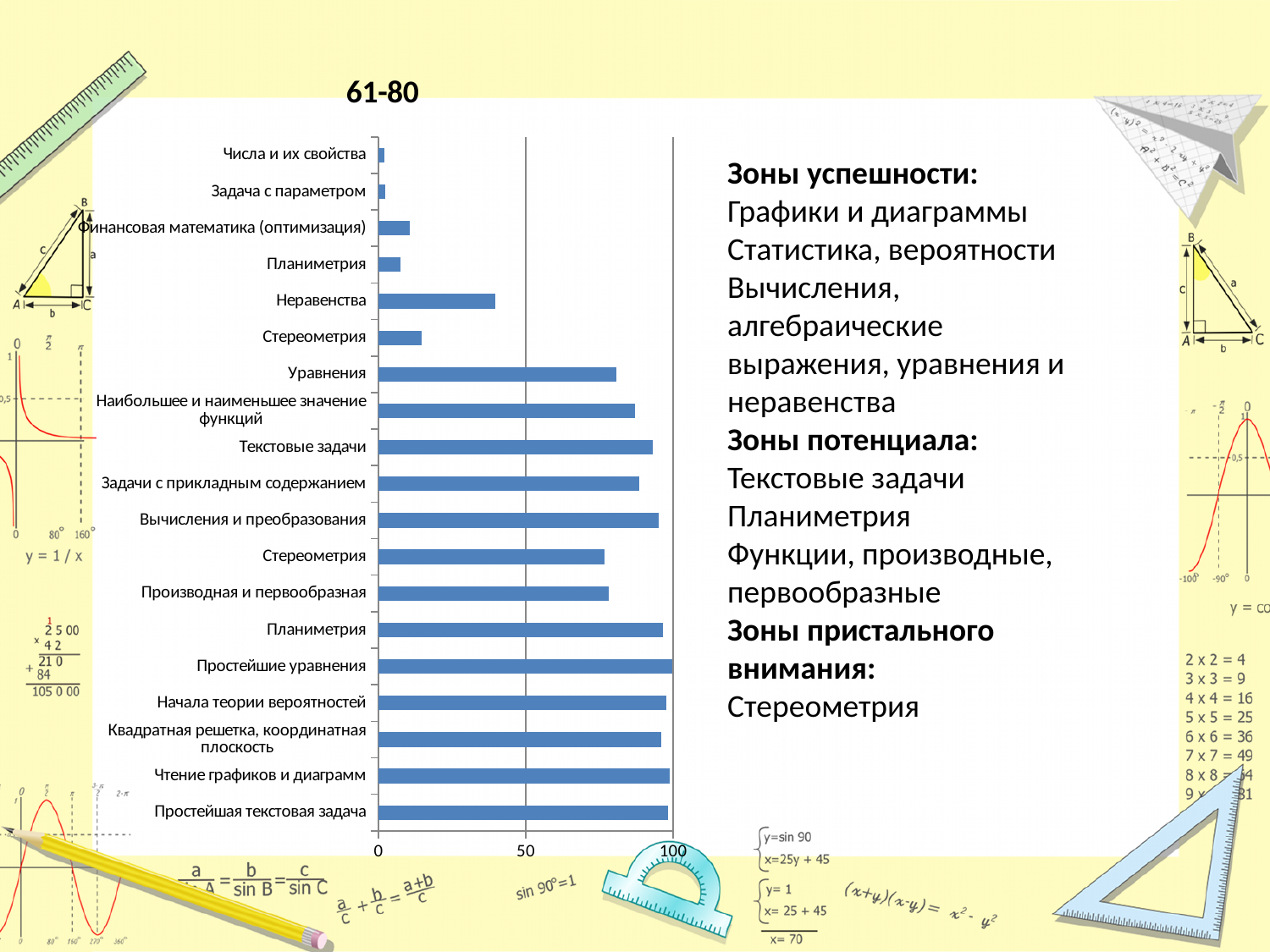
Is the value for Финансовая математика (оптимизация) greater or less than 50? less Is the value for Текстовые задачи greater or less than 50? greater Which has the larger value, Неравенства or Уравнения? Уравнения How many categories are plotted in the chart? 19 Is the value for Неравенства greater or less than 50? less Which has the larger value, Неравенства or Финансовая математика (оптимизация)? Неравенства What is the title of the chart? 61-80 What kind of chart is shown on the slide? bar chart What colour are the bars in the chart? blue Which has the larger value, Числа и их свойства or Вычисления и преобразования? Вычисления и преобразования